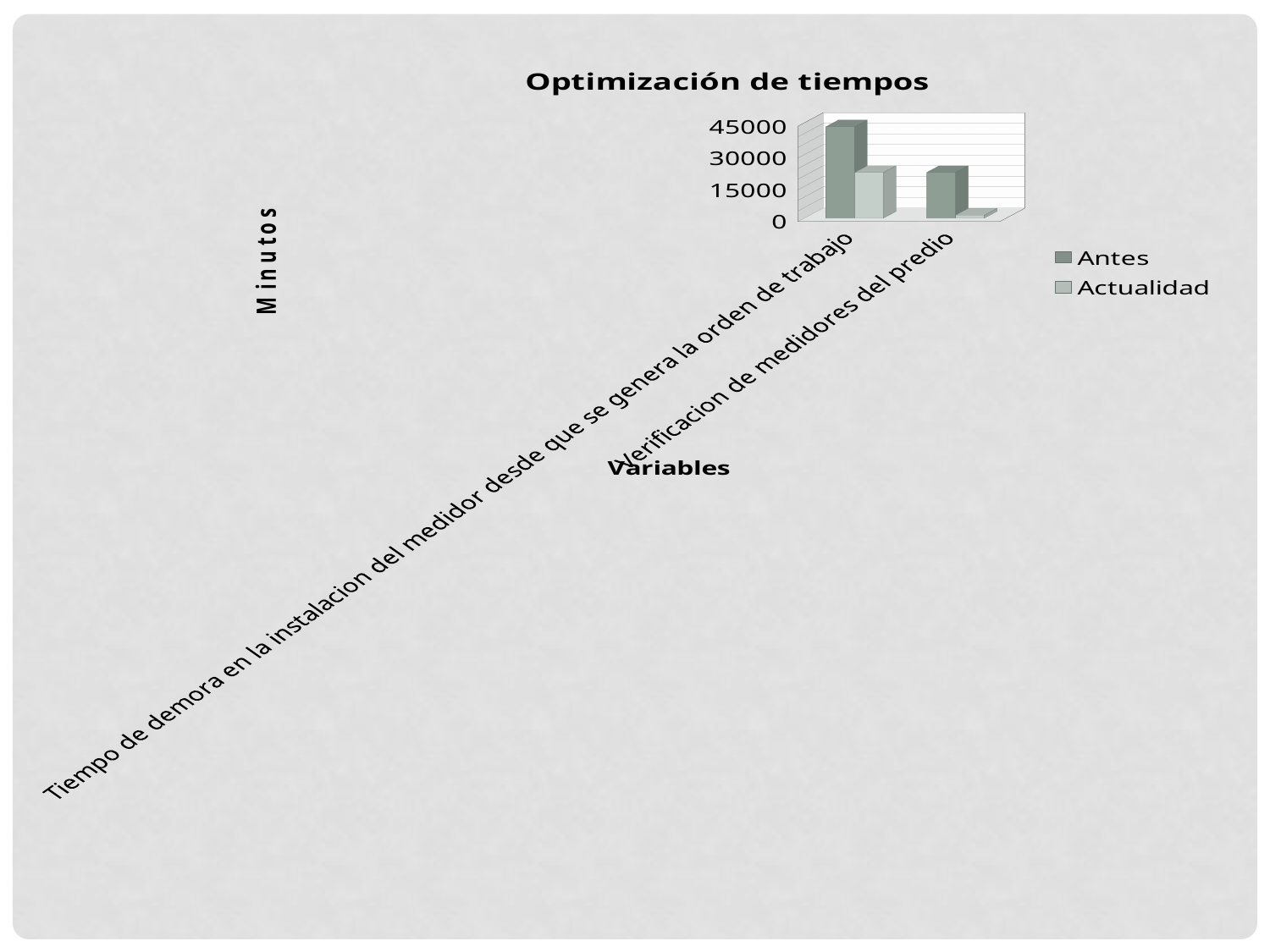
What is the label of the vertical axis? Minutos Is the 'Antes' value for 'Tiempo de demora en la instalacion del medidor desde que se genera la orden de trabajo' greater or less than 30000? greater Which bar is the lowest in the chart? Actualidad for Verificacion de medidores del predio What kind of chart is shown on the slide? bar chart How many series does the legend list? 2 Is the 'Actualidad' value for 'Verificacion de medidores del predio' greater or less than 15000? less What is the title of the chart? Optimización de tiempos Is the 'Actualidad' value for 'Tiempo de demora en la instalacion del medidor desde que se genera la orden de trabajo' greater or less than 30000? less For 'Verificacion de medidores del predio', which series has the larger value, 'Antes' or 'Actualidad'? Antes Which bar is the highest in the chart? Antes for Tiempo de demora en la instalacion del medidor desde que se genera la orden de trabajo How many categories are shown on the x axis? 2